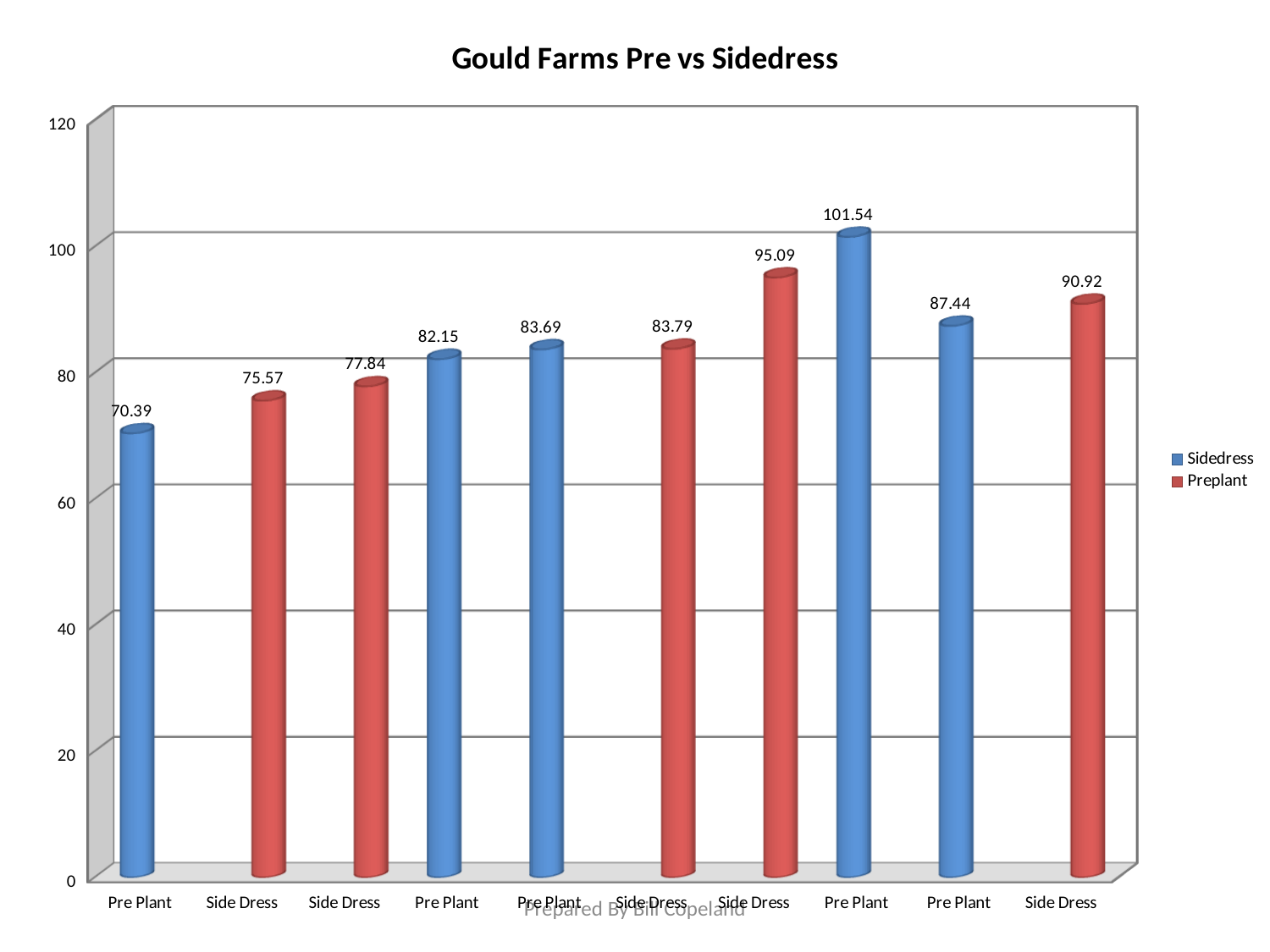
How many series does the legend list? 2 How many bars are plotted in the chart? 10 What is the highest value shown in the chart? 101.54 What are the two series named in the legend? Sidedress and Preplant Is the value of the second bar from the left (Side Dress, 75.57) greater or less than 80? less What is the value of the first bar from the left (Pre Plant)? 70.39 What kind of chart is shown on the slide? bar chart What is the value of the last bar on the right (Side Dress)? 90.92 Which is larger: the bar labelled 87.44 or the bar labelled 90.92? 90.92 What is the title of the chart? Gould Farms Pre vs Sidedress What is the difference between the highest value (101.54) and the lowest value (70.39)? 31.15 What is the lowest value shown in the chart? 70.39